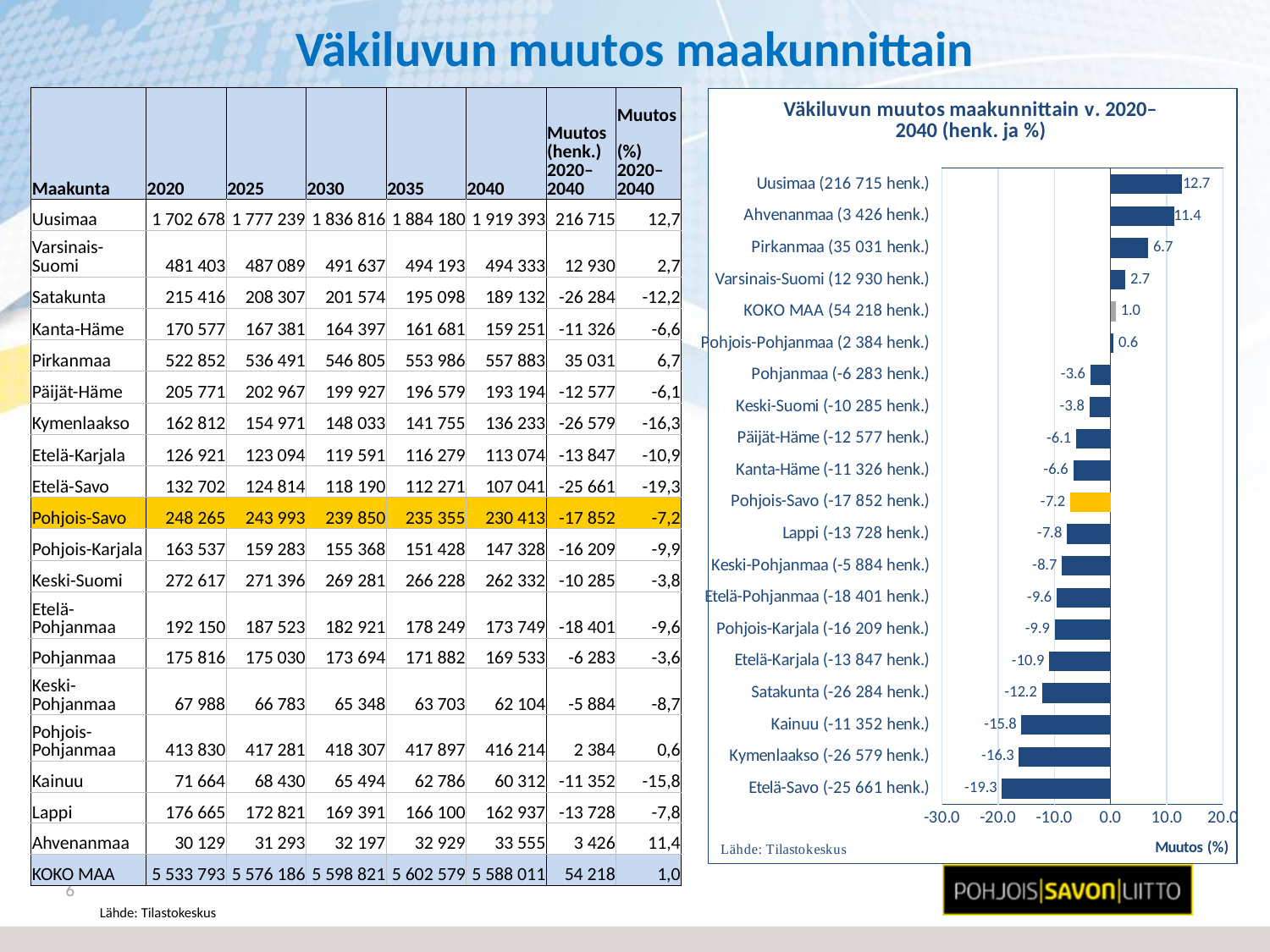
In the chart, what is the difference between the percentage change for Uusimaa and for Ahvenanmaa? 1.3 What is the title of the chart on the slide? Väkiluvun muutos maakunnittain v. 2020–2040 (henk. ja %) In the chart, what is the percentage change shown for Kymenlaakso? -16.3 What kind of chart is shown on the slide? bar chart Which region's bar is highlighted in yellow in the chart? Pohjois-Savo Which region has the highest percentage change in the chart? Uusimaa In the chart, what is the percentage change shown for KOKO MAA? 1.0 In the chart, which has a larger percentage change, Pirkanmaa or Varsinais-Suomi? Pirkanmaa In the chart, what is the percentage change shown for Uusimaa? 12.7 Which region has the lowest percentage change in the chart? Etelä-Savo In the chart, what is the percentage change shown for Pohjois-Savo? -7.2 How many regions (bars) are shown in the chart? 20